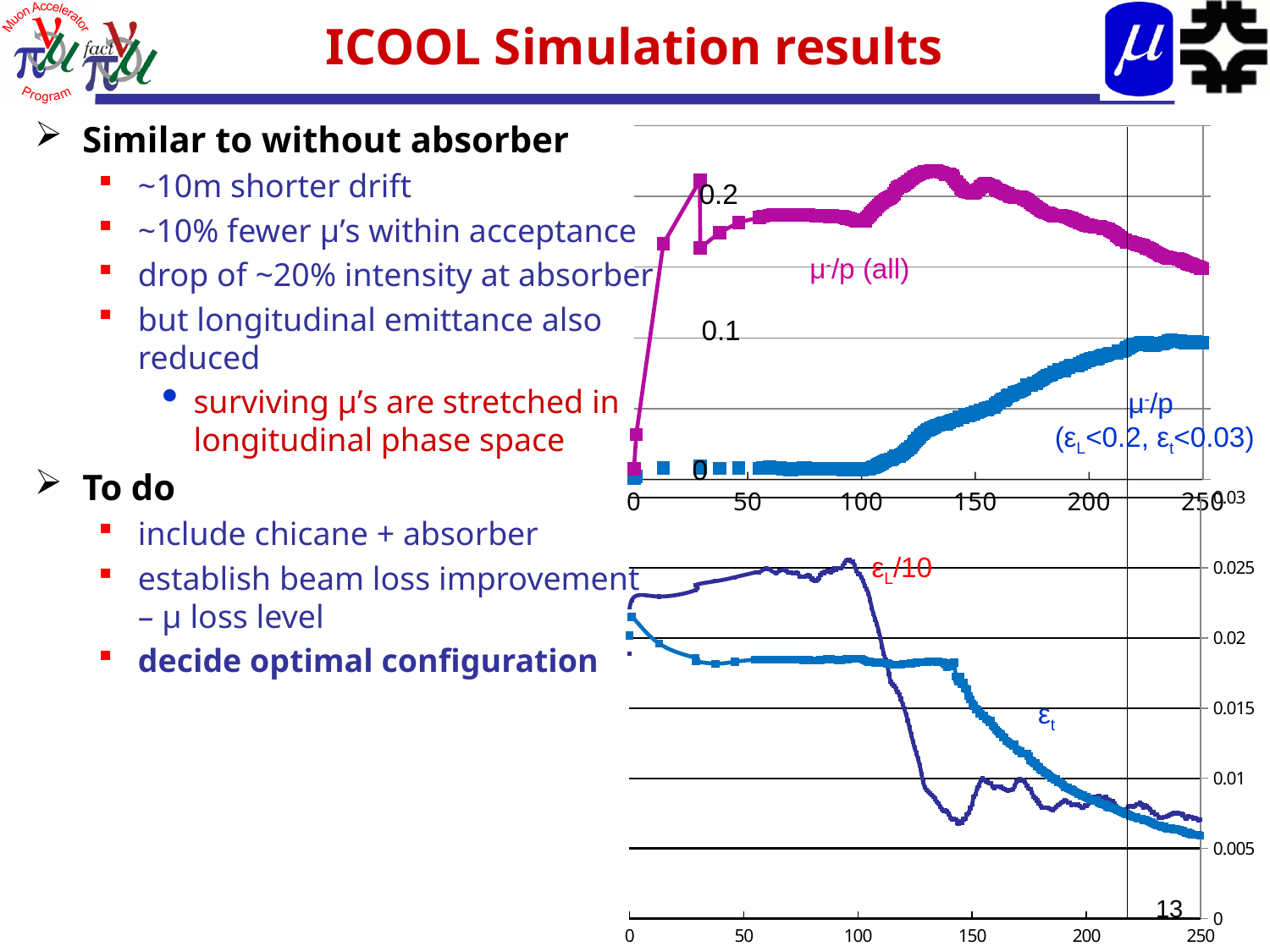
What kind of chart is the bottom chart on the right of the slide? line chart In the bottom chart, is the value of εL/10 at x = 50 greater or less than 0.02? greater What is the highest value shown on the y axis of the bottom chart? 0.03 In the top chart, which series is higher at x = 250: μ⁻/p (all) or μ⁻/p (εL<0.2, εt<0.03)? μ⁻/p (all) In the bottom chart, is the value of εt at x = 250 greater or less than 0.01? less In the top chart, does the μ⁻/p (all) series rise or fall between x = 150 and x = 250? fall In the top chart, is the value of μ⁻/p (all) at x = 250 greater or less than 0.1? greater How many data series are plotted in the top chart (μ⁻/p)? 2 In the bottom chart, which series is higher at x = 50: εL/10 or εt? εL/10 In the top chart, does the μ⁻/p (εL<0.2, εt<0.03) series rise or fall between x = 100 and x = 200? rise What kind of chart is the top chart on the right of the slide? line chart